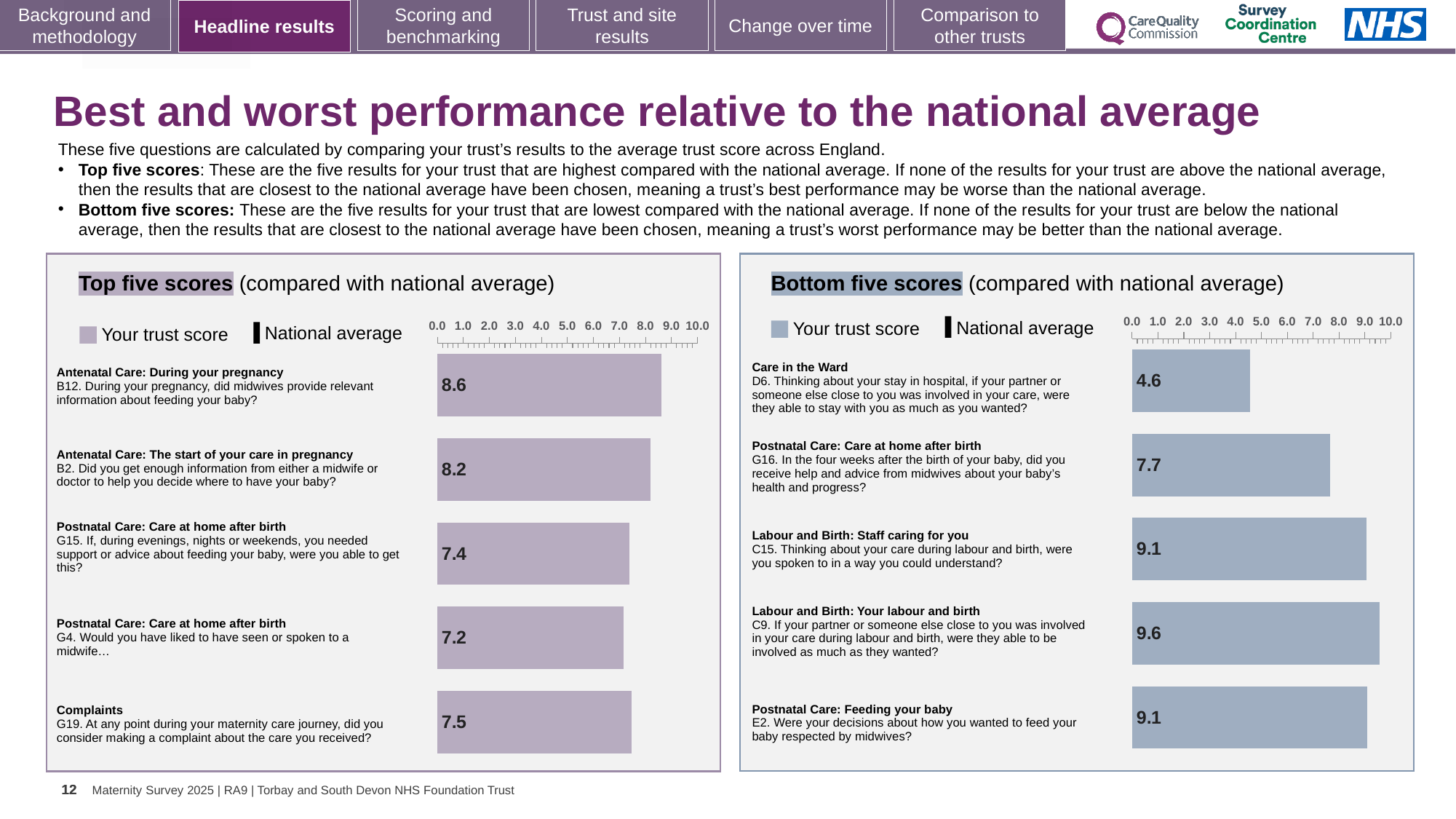
In the Top five scores chart, what is the difference between the trust scores for B12 and G4? 1.4 In the Top five scores chart, what is the trust score for B12 (Antenatal Care: During your pregnancy)? 8.6 How many bars are shown in the Top five scores chart? 5 How many entries does the legend of the Bottom five scores chart list? 2 In the Bottom five scores chart, what is the trust score for D6 (Care in the Ward)? 4.6 In the Bottom five scores chart, which has the larger trust score, C9 or G16? C9 What type of chart is the Top five scores chart? Bar chart In the Top five scores chart, is the trust score for G15 greater or less than 5.0? greater In the Bottom five scores chart, which question has the lowest trust score? D6 (Care in the Ward) In the Bottom five scores chart, what is the difference between the trust scores for C9 and D6? 5.0 In the Top five scores chart, which question has the highest trust score? B12 (Antenatal Care: During your pregnancy) In the Bottom five scores chart, which question has the highest trust score? C9 (Labour and Birth: Your labour and birth)